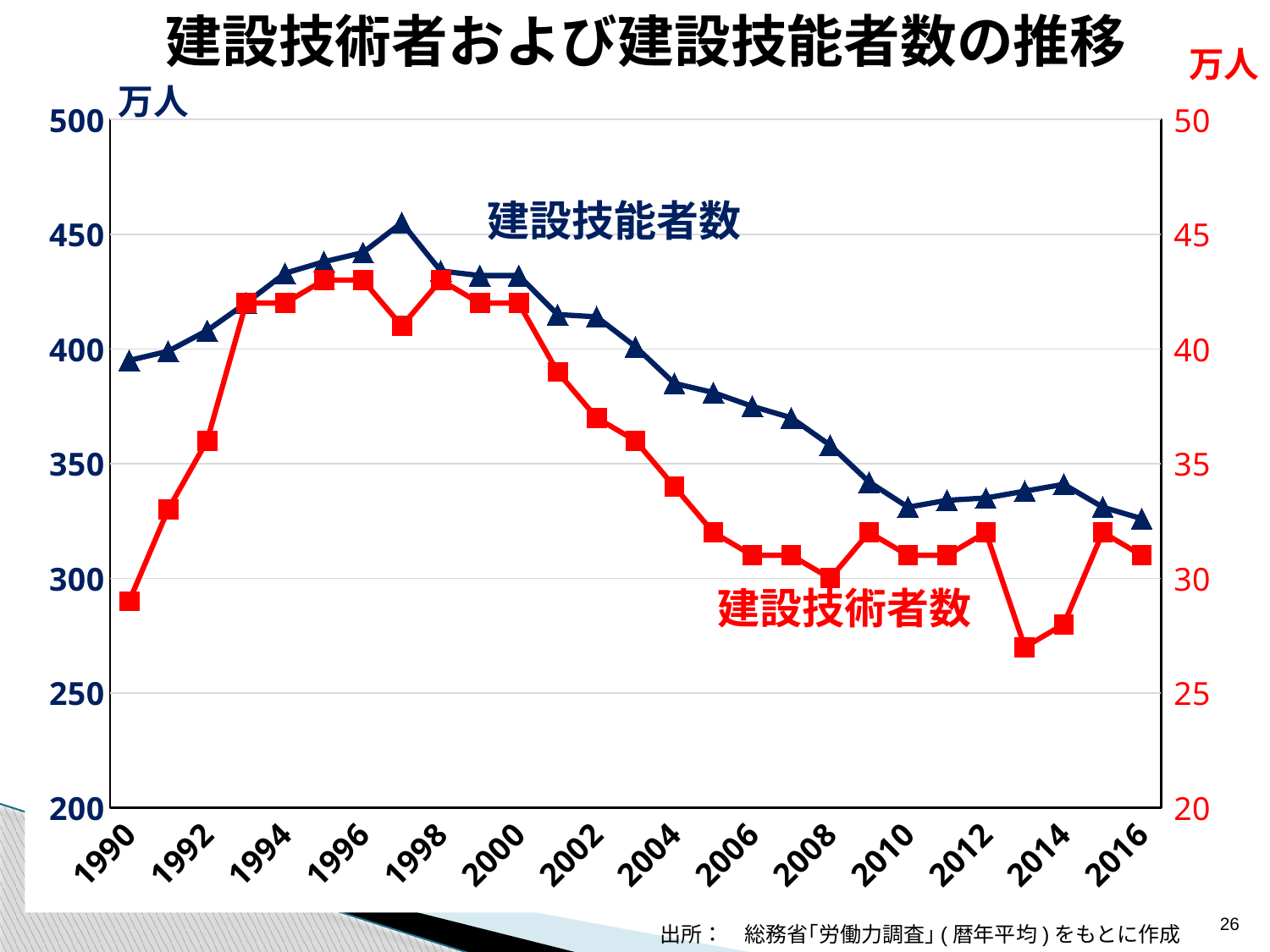
Is the value for 建設技術者数 in 1995 greater or less than 40 on the right axis? greater Which series is higher on its own axis in 1990, 建設技能者数 (left axis) or 建設技術者数 (right axis)? 建設技能者数 In which year does the 建設技能者数 series reach its highest value? 1997 Is the value for 建設技能者数 in 1997 greater or less than 450 on the left axis? greater In which year does the 建設技術者数 series reach its lowest value? 2013 Is the value for 建設技能者数 in 2010 greater or less than 350 on the left axis? less What kind of chart is shown on the slide? line chart How many data series are plotted on the chart? 2 What unit is shown on both vertical axes of the chart? 万人 What is the title of the chart? 建設技術者および建設技能者数の推移 Does the 建設技能者数 series rise or fall between 1997 and 2010? fall